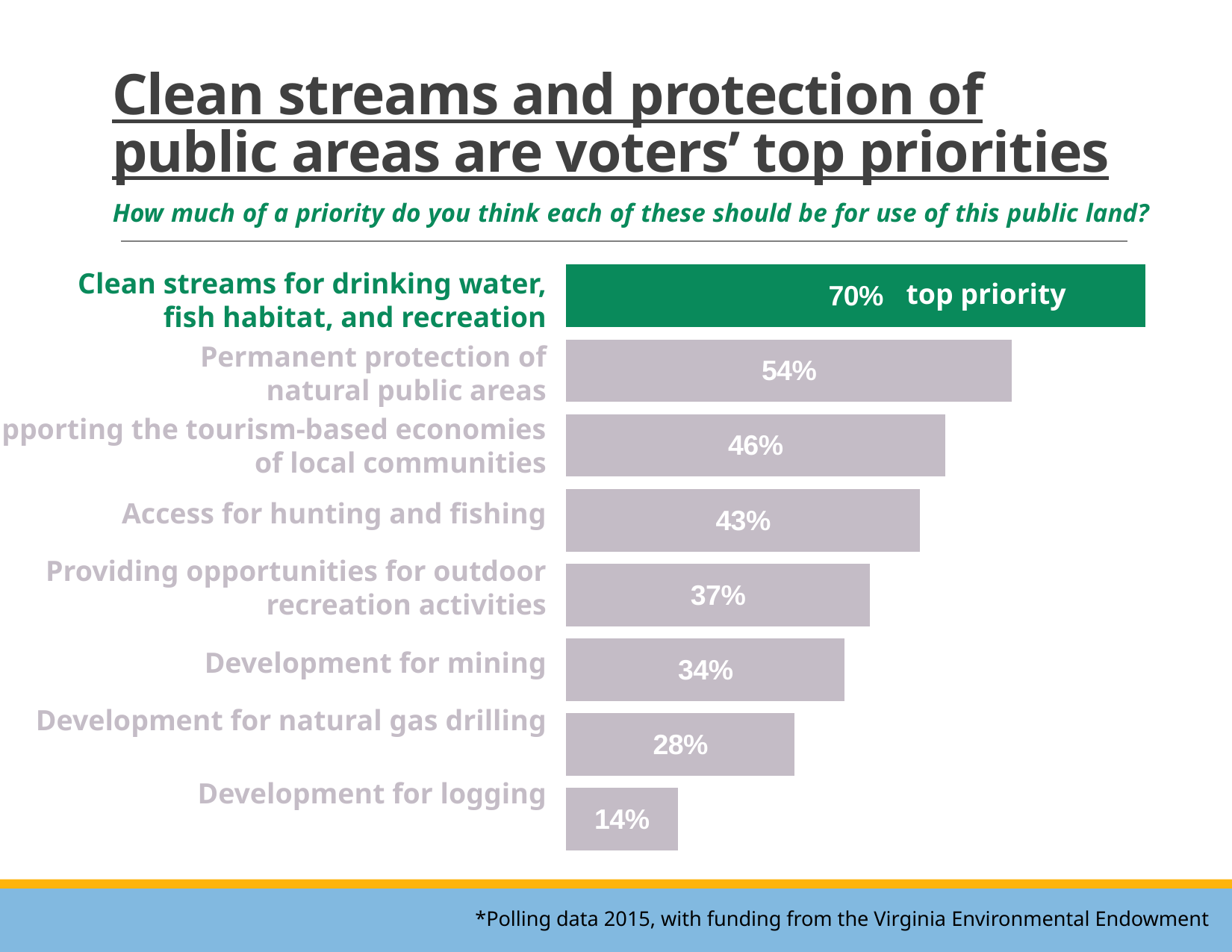
What percentage of voters rated clean streams for drinking water, fish habitat, and recreation as a top priority? 70% What is the value shown for development for natural gas drilling? 28% Which is larger: the value for access for hunting and fishing or the value for providing opportunities for outdoor recreation activities? Access for hunting and fishing Which bar is coloured green rather than grey? Clean streams for drinking water, fish habitat, and recreation What is the value shown for permanent protection of natural public areas? 54% What is the difference between the values for development for mining and development for logging? 20% What is the difference between the values for clean streams for drinking water, fish habitat, and recreation and permanent protection of natural public areas? 16% Which category has the highest value? Clean streams for drinking water, fish habitat, and recreation Which category has the lowest value? Development for logging What is the value shown for access for hunting and fishing? 43% How many categories are shown in the chart? 8 What kind of chart is shown on the slide? Bar chart